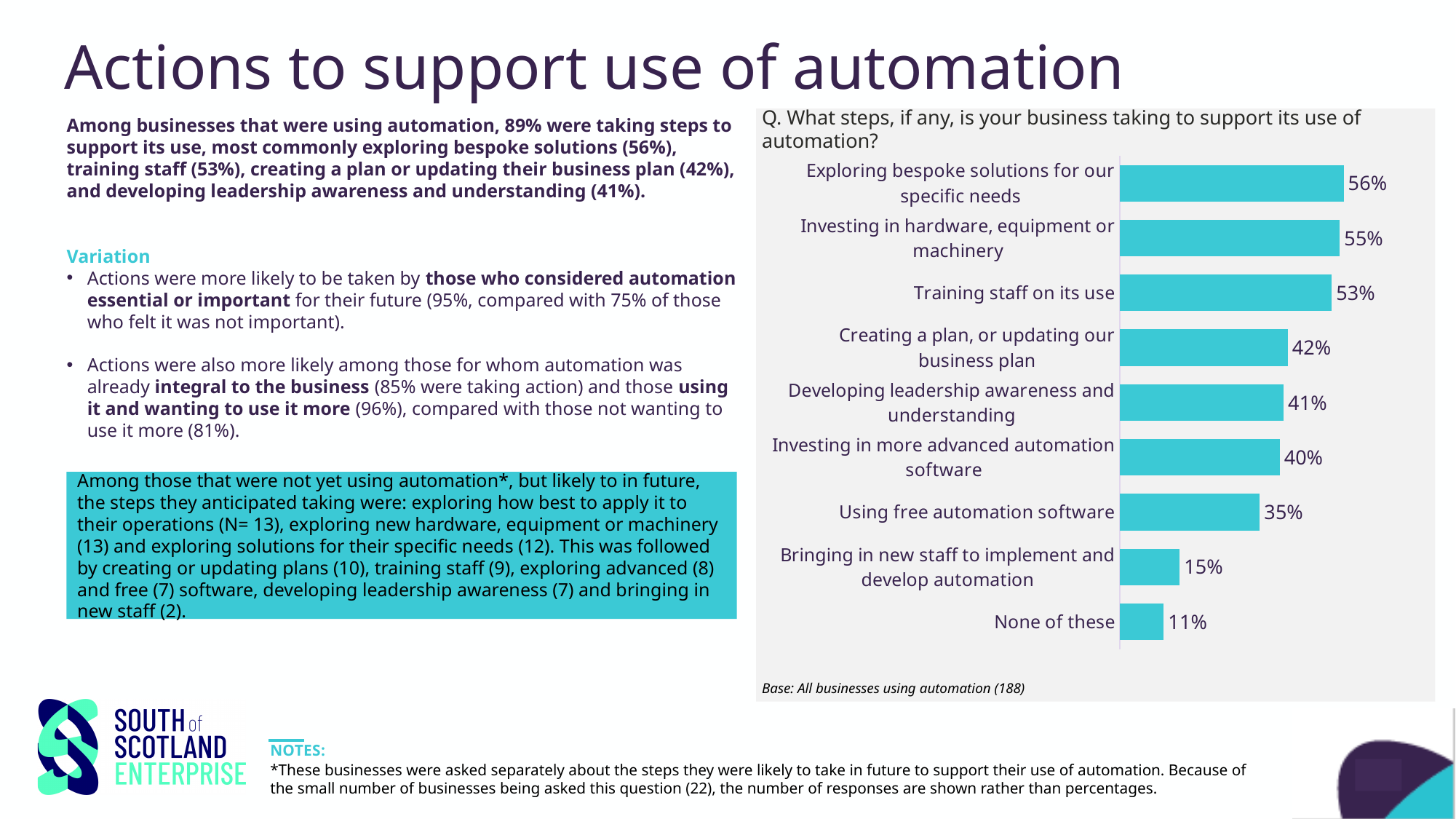
What is the base stated below the chart? All businesses using automation (188) What percentage of businesses were bringing in new staff to implement and develop automation? 15% Which category has the lowest percentage in the chart? None of these What percentage of businesses were exploring bespoke solutions for their specific needs? 56% What percentage of businesses were training staff on its use? 53% What is the difference in percentage points between 'Developing leadership awareness and understanding' and 'Bringing in new staff to implement and develop automation'? 26 What is the difference in percentage points between 'Creating a plan, or updating our business plan' and 'Using free automation software'? 7 What type of chart is shown on the slide? Bar chart Which is larger: the value for 'Investing in hardware, equipment or machinery' or the value for 'Investing in more advanced automation software'? Investing in hardware, equipment or machinery What percentage of businesses selected 'None of these'? 11% How many categories are shown in the chart? 9 Which action has the highest percentage in the chart? Exploring bespoke solutions for our specific needs